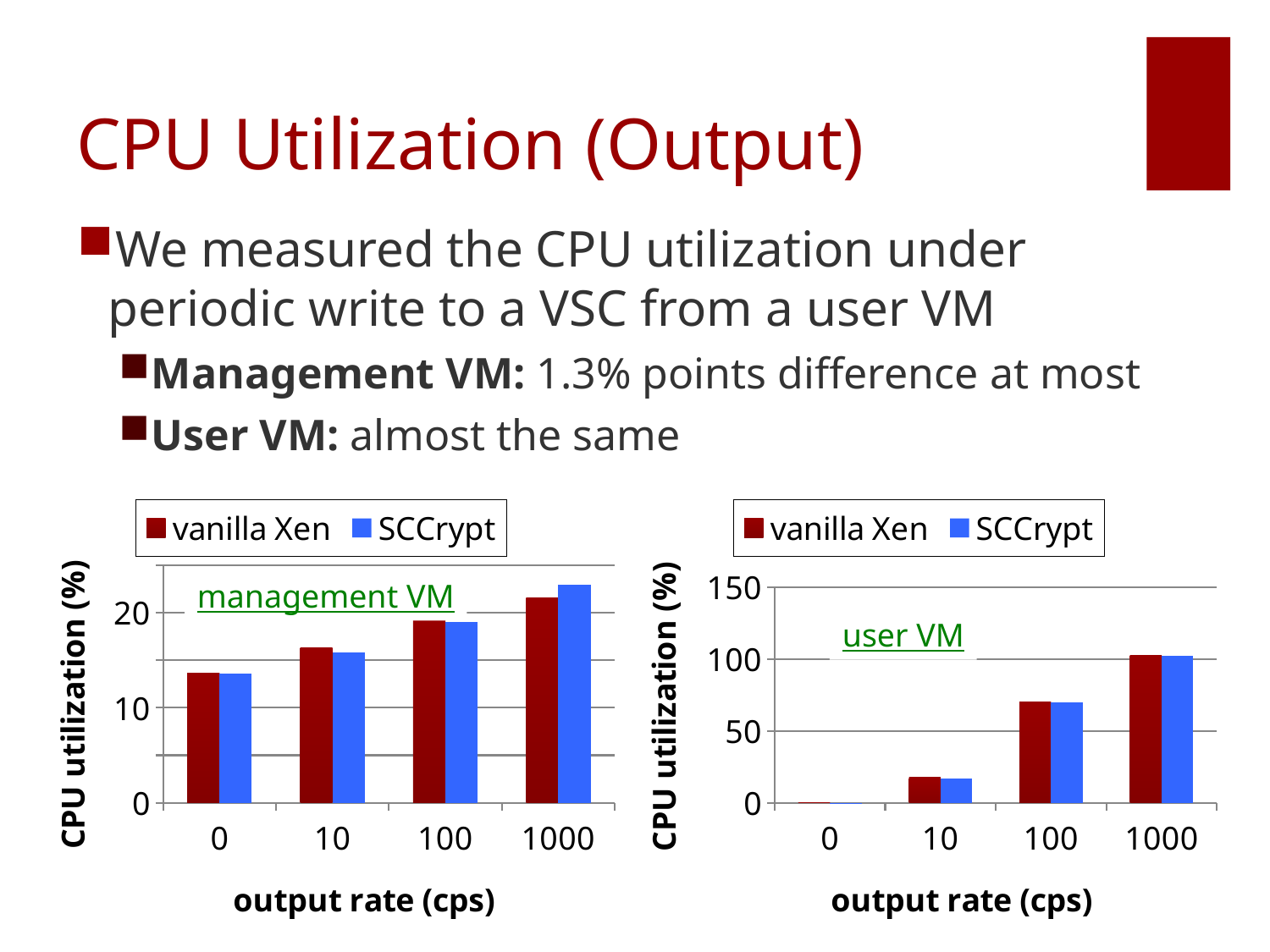
In the user VM chart, is the vanilla Xen value at output rate 100 greater or less than 50? greater In the user VM chart, which output rate has the highest CPU utilization for vanilla Xen? 1000 In the management VM chart, how many output rate categories are shown on the x axis? 4 In the user VM chart, is the SCCrypt value at output rate 10 greater or less than 50? less In the management VM chart, which series has the larger value at output rate 1000, vanilla Xen or SCCrypt? SCCrypt In the management VM chart, is the vanilla Xen value at output rate 0 greater or less than 10? greater In the user VM chart, do the CPU utilization values rise or fall as the output rate increases? rise What is the x-axis label of the user VM chart? output rate (cps) In the management VM chart, which output rate has the lowest CPU utilization for SCCrypt? 0 How many series does the legend of the user VM chart list? 2 What kind of chart is the management VM chart on the left? bar chart